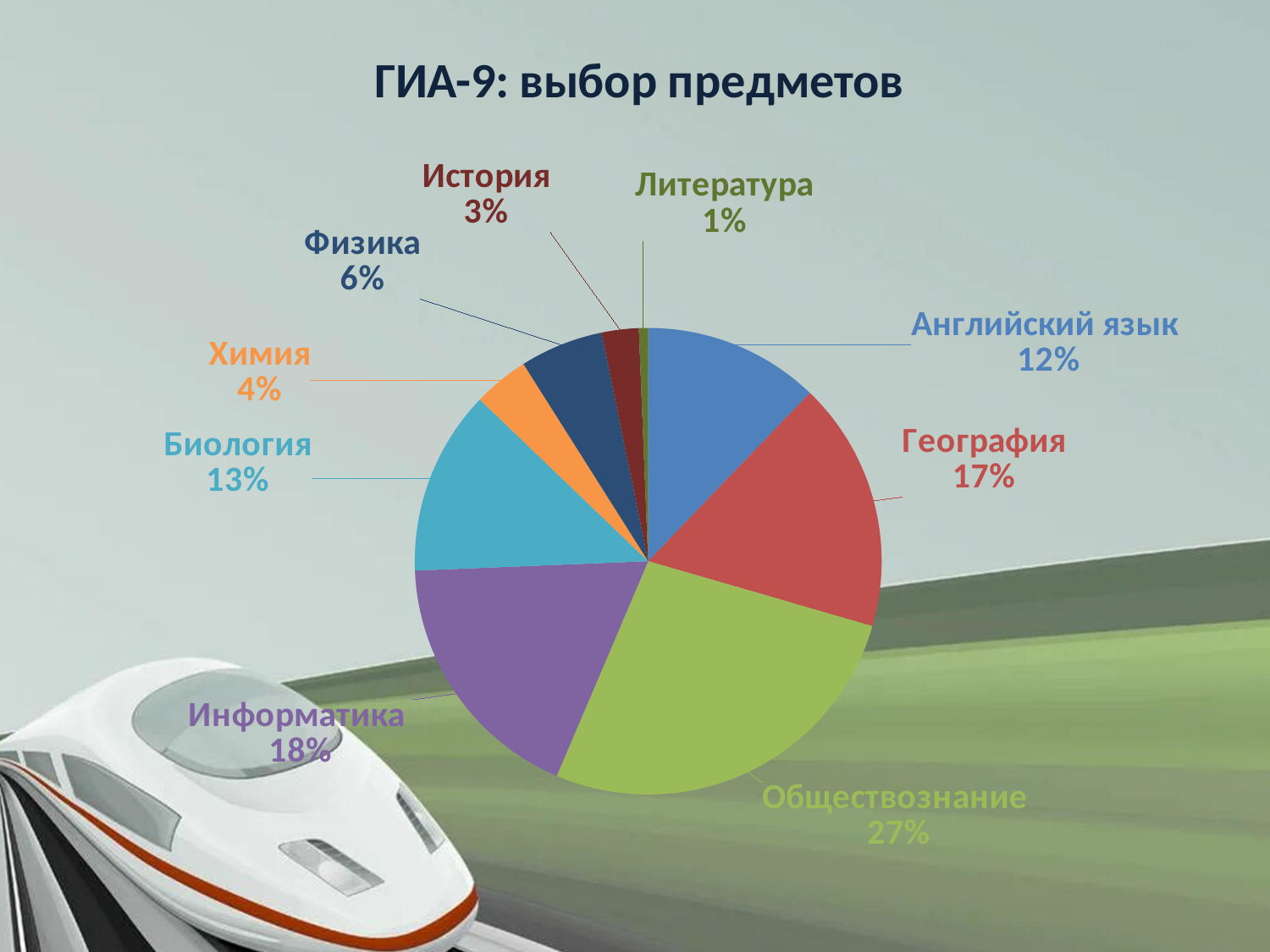
How many subjects are shown in the pie chart? 9 What share of the pie does Обществознание have? 27% What is the title of the chart? ГИА-9: выбор предметов What is the value for Английский язык? 12% Which subject has the largest slice? Обществознание What kind of chart is shown on the slide? pie chart Which subject has the smallest slice? Литература What is the difference between География and Физика? 11% What is the combined share of История and Литература? 4% What is the value for Химия? 4% Which is larger, Биология or Английский язык? Биология What is the value for Информатика? 18%